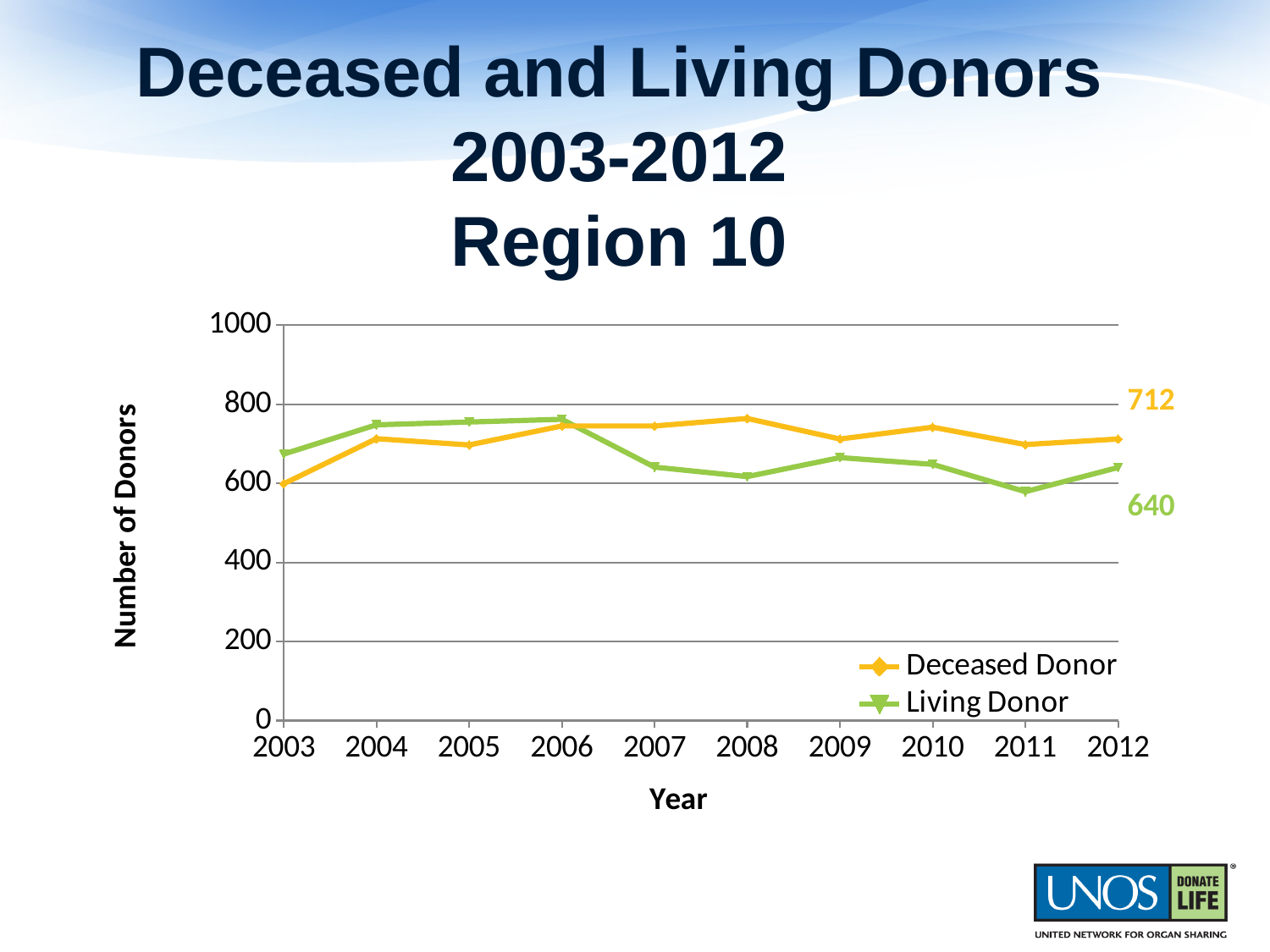
What is the value for Living Donor in 2012? 640 Is the value for Living Donor in 2004 greater or less than 600? greater What is the difference between the Deceased Donor and Living Donor values in 2012? 72 How many years are shown on the x axis? 10 In which year is the Deceased Donor value lowest? 2003 Is the value for Living Donor in 2011 greater or less than 600? less In which year is the Living Donor value lowest? 2011 How many series does the legend list? 2 In 2012, which series has the larger value, Deceased Donor or Living Donor? Deceased Donor Is the value for Deceased Donor in 2008 greater or less than 800? less What kind of chart is shown on the slide? line chart What is the value for Deceased Donor in 2012? 712